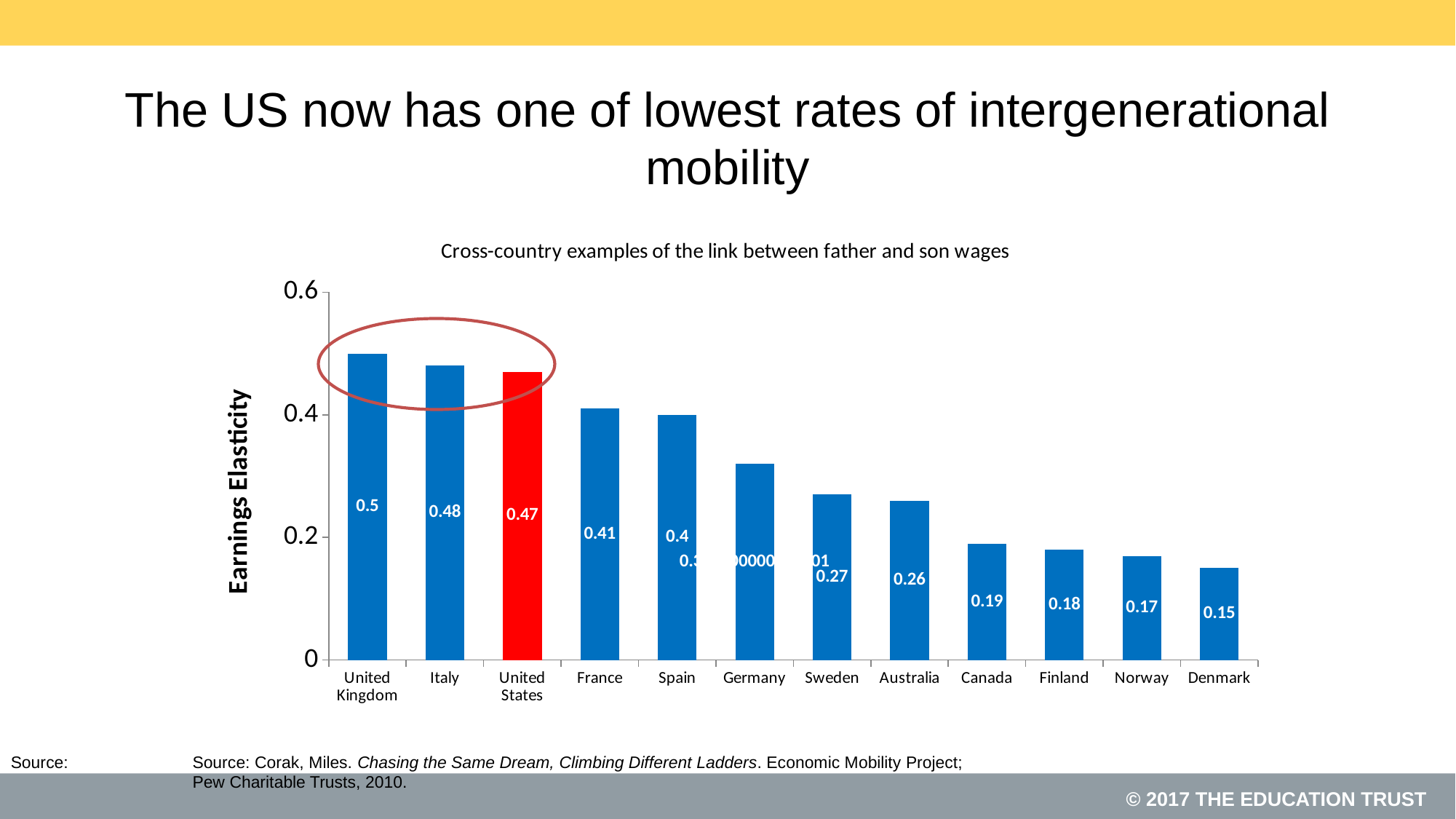
What is the earnings elasticity value for the United States? 0.47 Which has a higher earnings elasticity, France or Sweden? France Which country has the lowest earnings elasticity? Denmark Which country has the highest earnings elasticity? United Kingdom What type of chart is shown on the slide? Bar chart What is the difference in earnings elasticity between the United Kingdom and Denmark? 0.35 What is the earnings elasticity value for Canada? 0.19 What is the earnings elasticity value for Italy? 0.48 How many countries are shown in the chart? 12 Is the value for Germany greater or less than 0.4? less Do the values rise or fall moving from left to right along the x axis? Fall Which country's bar is coloured red? United States